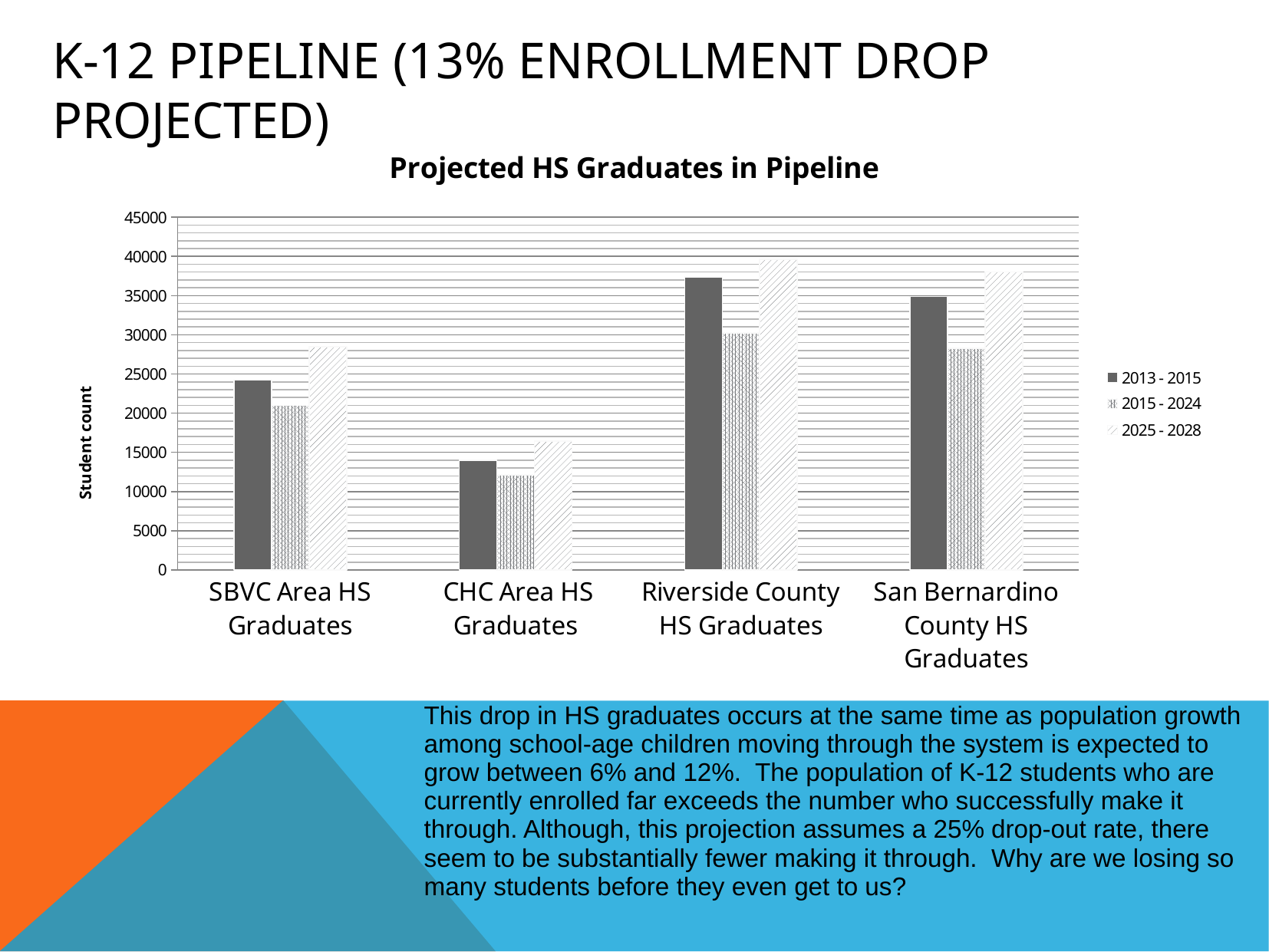
For Riverside County HS Graduates, which is larger: the 2013 - 2015 value or the 2015 - 2024 value? 2013 - 2015 Is the 2025 - 2028 value for Riverside County HS Graduates greater or less than 35000? greater Is the 2015 - 2024 value for CHC Area HS Graduates greater or less than 15000? less What is the label of the y axis? Student count How many series does the legend list? 3 Is the 2013 - 2015 value for SBVC Area HS Graduates greater or less than 20000? greater Which category has the lowest 2015 - 2024 value? CHC Area HS Graduates What is the title of the chart? Projected HS Graduates in Pipeline What type of chart is shown on the slide? bar chart Which category has the highest 2013 - 2015 value? Riverside County HS Graduates How many categories are shown on the x axis? 4